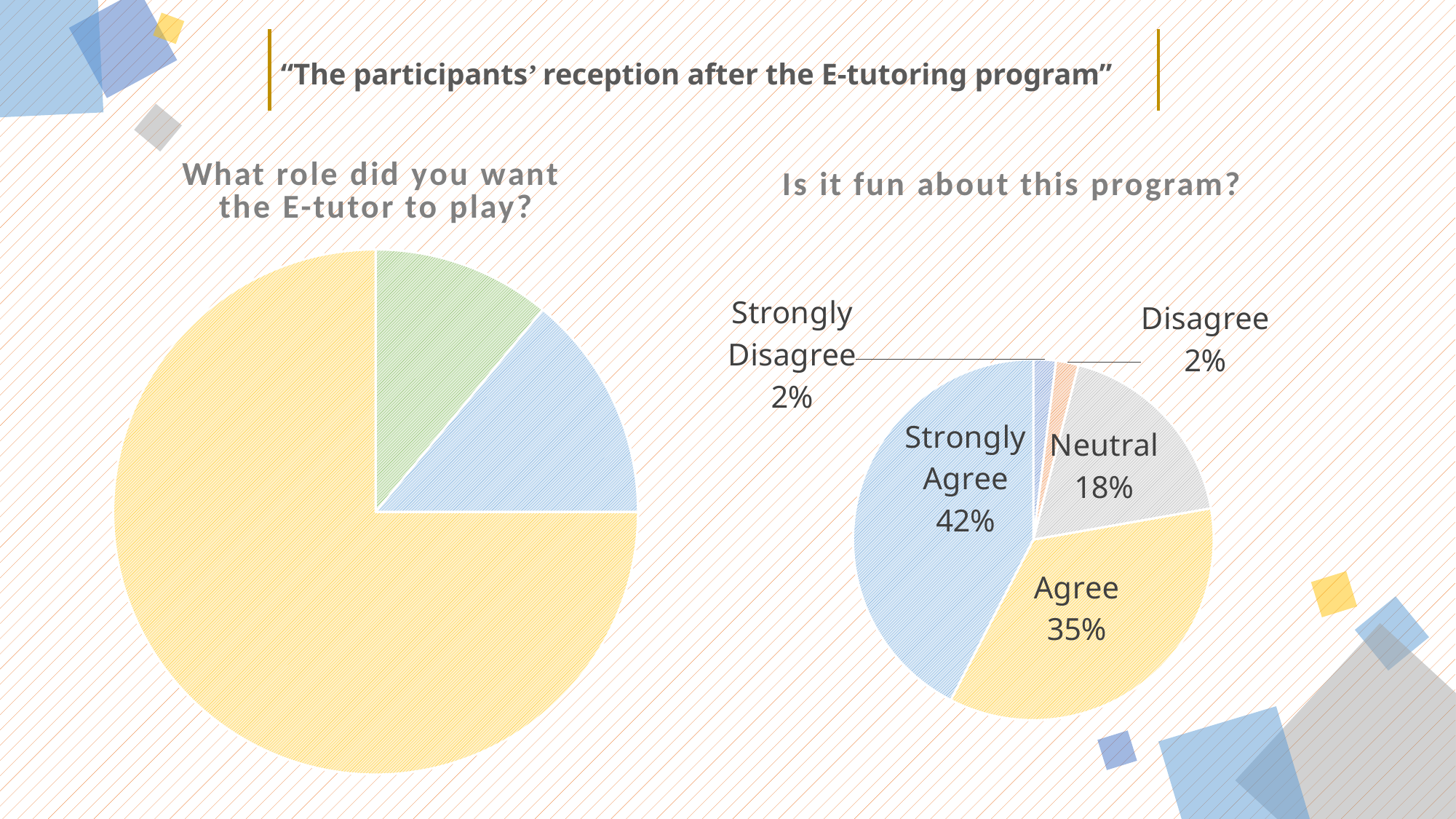
On the chart titled "Is it fun about this program?", what percentage answered Agree? 35% On the chart titled "Is it fun about this program?", what percentage answered Disagree? 2% On the chart titled "Is it fun about this program?", what share of participants answered Strongly Agree? 42% On the chart titled "Is it fun about this program?", what percentage answered Neutral? 18% On the chart titled "Is it fun about this program?", which response has the largest share? Strongly Agree On the chart titled "Is it fun about this program?", how many response categories are shown? 5 On the chart titled "Is it fun about this program?", which is larger, the Neutral share or the Agree share? Agree On the chart titled "Is it fun about this program?", what is the combined share of Strongly Agree and Agree? 77% How many slices does the pie chart titled "What role did you want the E-tutor to play?" have? 3 What kind of chart is used for "What role did you want the E-tutor to play?"? Pie chart On the chart titled "Is it fun about this program?", what is the difference between the Strongly Agree and Agree shares? 7% On the chart titled "What role did you want the E-tutor to play?", what colour is the largest slice? Yellow